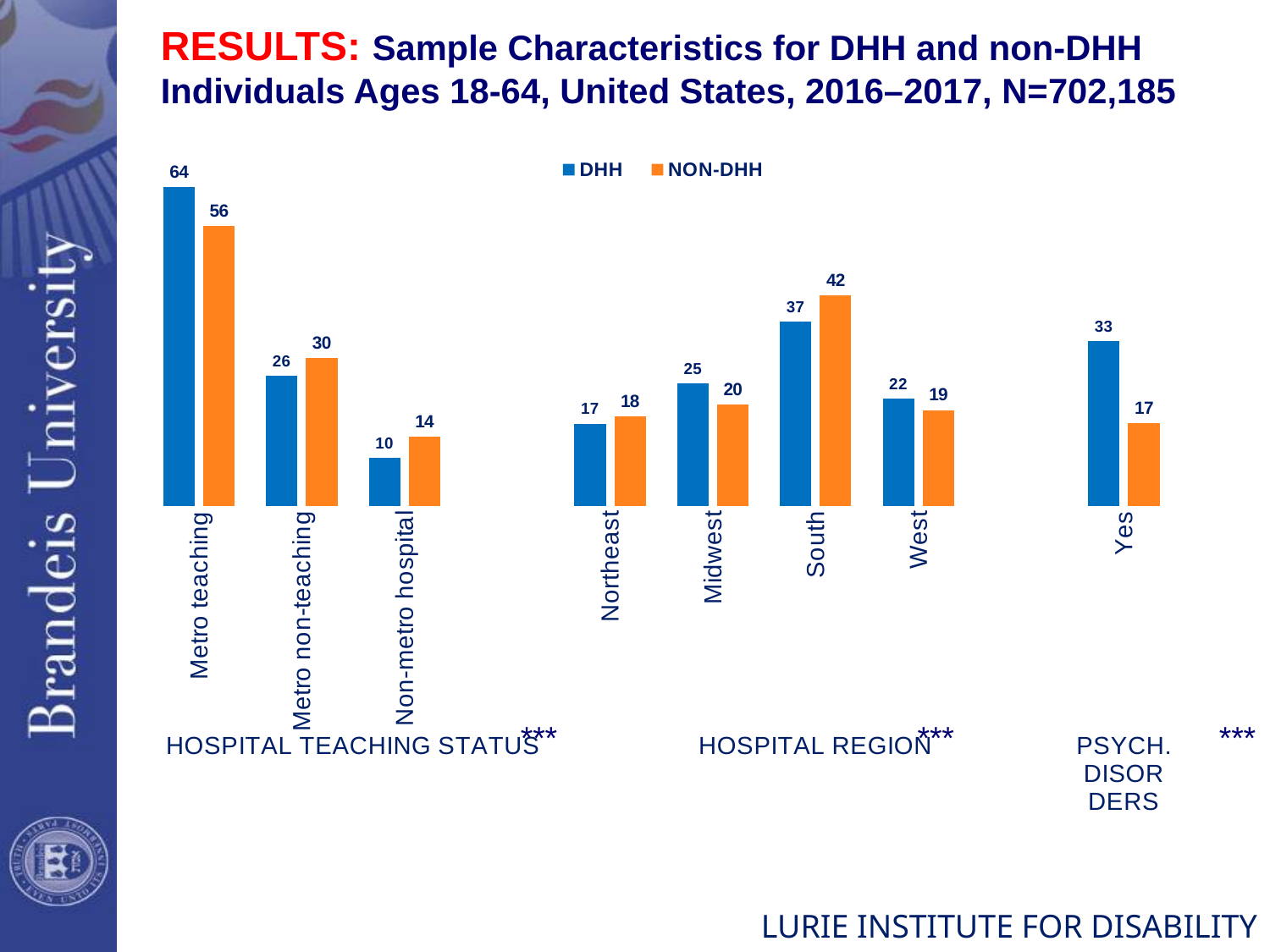
What is the NON-DHH value for South? 42 How many series does the legend list? 2 How many categories are shown on the x axis? 8 What is the difference between the DHH and NON-DHH values for Psych. disorders (Yes)? 16 Which category has the lowest NON-DHH value? Non-metro hospital What is the DHH value for Psych. disorders (Yes)? 33 What is the DHH value for Metro teaching? 64 What kind of chart is shown on the slide? Bar chart For Midwest, which series has the larger value, DHH or NON-DHH? DHH Which category has the highest DHH value? Metro teaching What is the difference between the DHH and NON-DHH values for Metro teaching? 8 Which colour represents the NON-DHH series? Orange